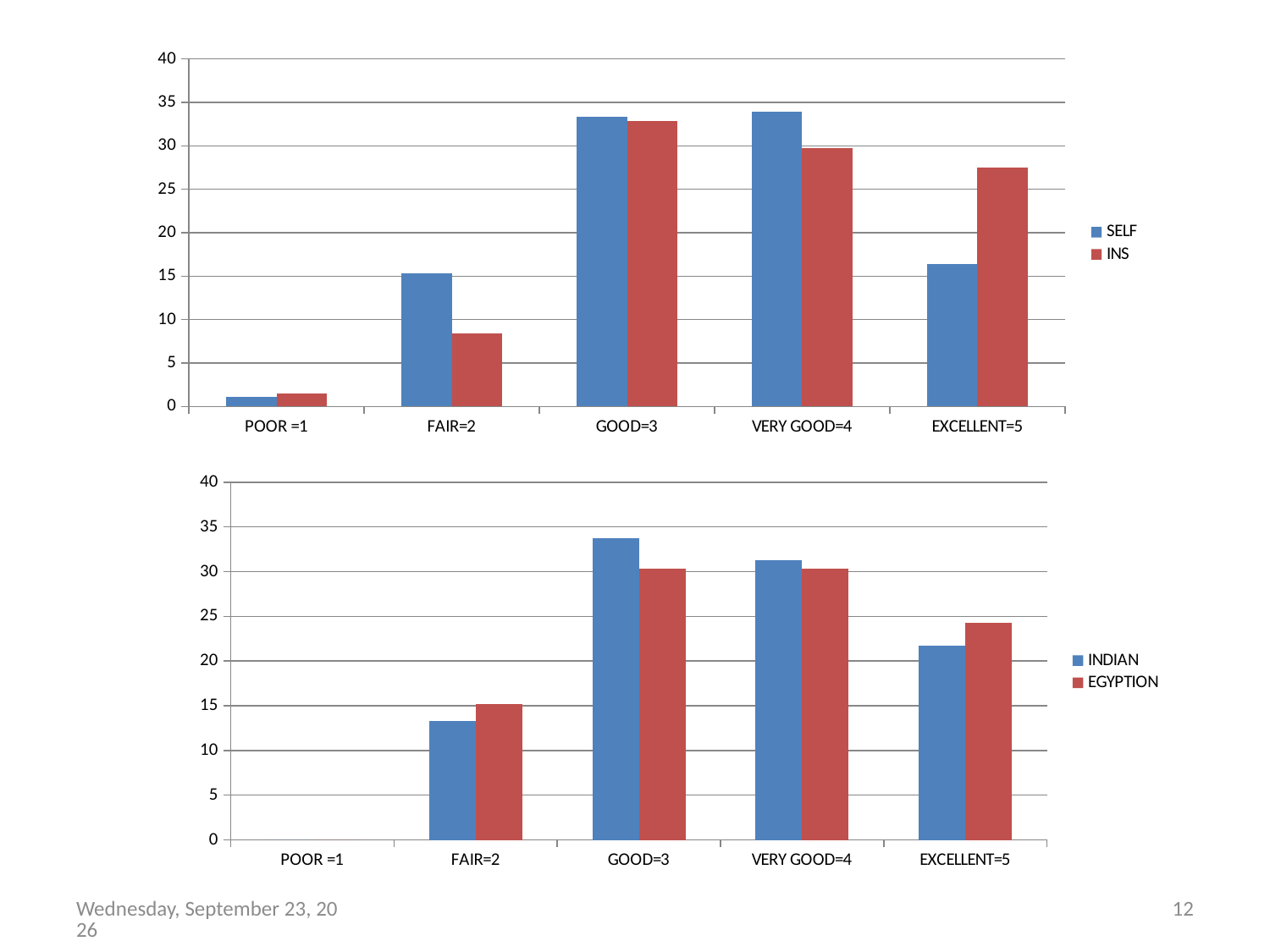
How many categories are shown on the x axis of the bottom chart? 5 In the bottom chart, which category has the highest INDIAN value? GOOD=3 In the bottom chart, which is larger for EXCELLENT=5, INDIAN or EGYPTION? EGYPTION In the top chart, which category has the lowest SELF value? POOR =1 In the top chart, is the SELF value for FAIR=2 greater or less than 10? greater How many series does the legend of the top chart list? 2 What kind of chart is the top chart on the slide? bar chart What are the two series named in the legend of the bottom chart? INDIAN and EGYPTION In the top chart, is the INS value for FAIR=2 greater or less than 10? less In the top chart, which category has the highest INS value? GOOD=3 In the bottom chart, is the INDIAN value for GOOD=3 greater or less than 30? greater In the top chart, which is larger for EXCELLENT=5, SELF or INS? INS